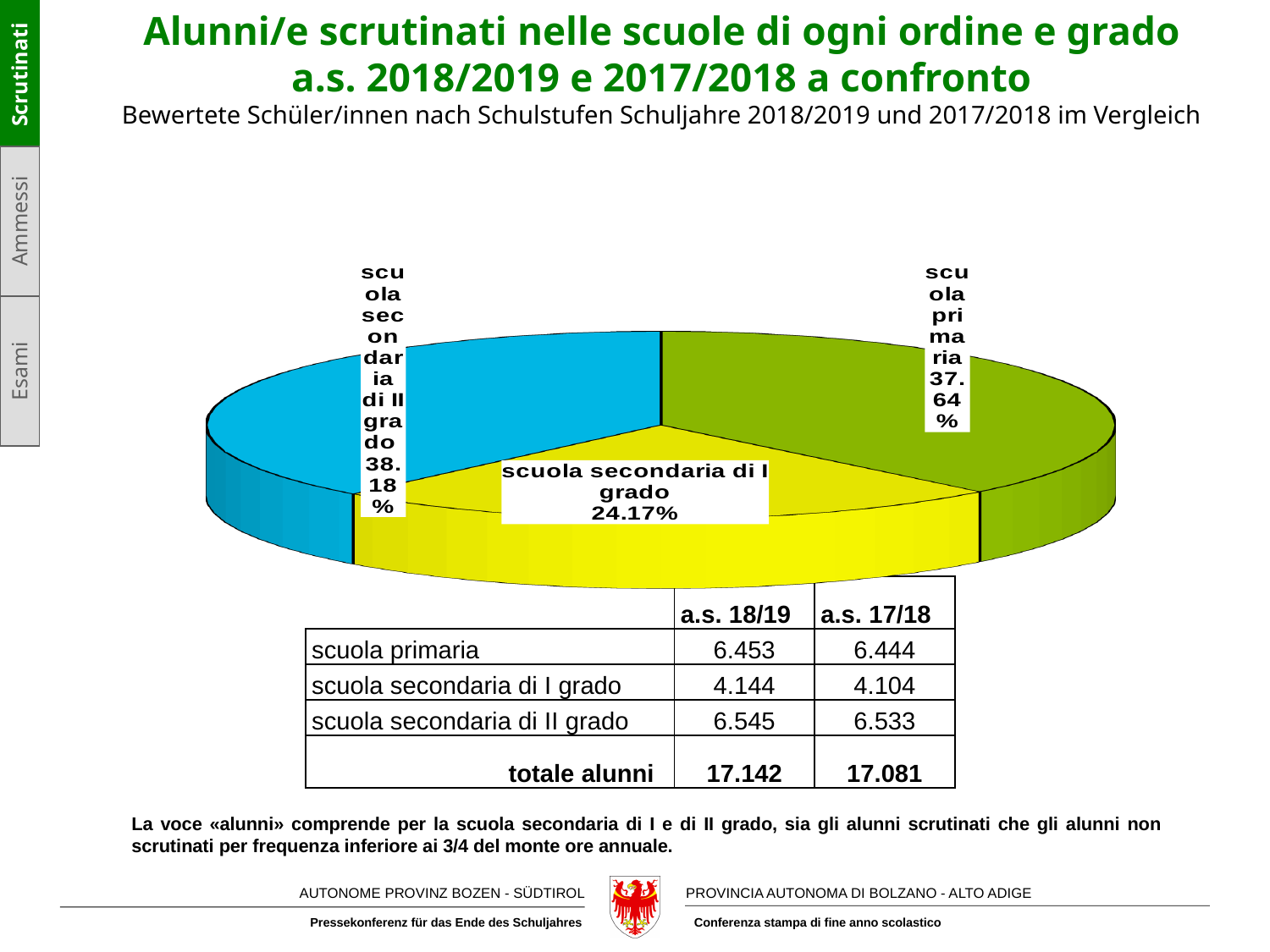
What share of the pie does scuola primaria represent? 37.64% How many slices does the pie chart have? 3 What is the difference in percentage points between the scuola primaria slice and the scuola secondaria di I grado slice? 13.47% What share of the pie does scuola secondaria di II grado represent? 38.18% What colour is the scuola secondaria di II grado slice of the pie chart? blue What kind of chart is shown on the slide? pie chart What colour is the scuola primaria slice of the pie chart? green Which slice of the pie chart is the largest? scuola secondaria di II grado Which slice of the pie chart is the smallest? scuola secondaria di I grado Which is larger in the pie chart, the scuola primaria slice or the scuola secondaria di I grado slice? scuola primaria What is the difference in percentage points between the scuola secondaria di II grado slice and the scuola secondaria di I grado slice? 14.01% What share of the pie does scuola secondaria di I grado represent? 24.17%